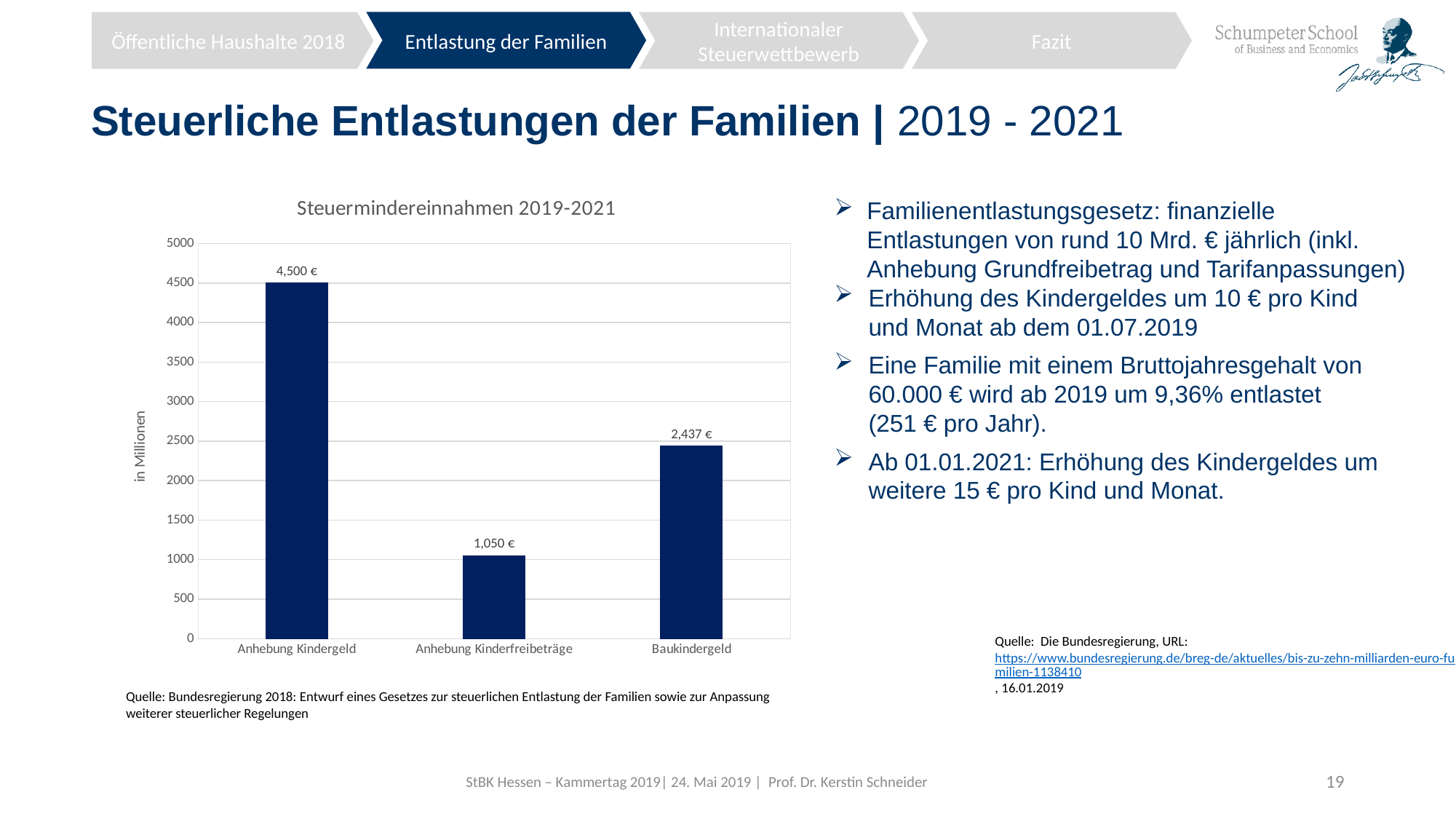
Which category has the lowest value? Anhebung Kinderfreibeträge Which category has the highest value? Anhebung Kindergeld Is the value for Baukindergeld greater or less than 2000? greater What kind of chart is shown on the slide? bar chart What is the difference between the values for Baukindergeld and Anhebung Kinderfreibeträge? 1,387 € What is the value for Anhebung Kinderfreibeträge? 1,050 € What is the difference between the values for Anhebung Kindergeld and Baukindergeld? 2,063 € What is the value for Baukindergeld? 2,437 € What is the value for Anhebung Kindergeld? 4,500 € How many categories are shown in the chart? 3 Which is larger, the value for Baukindergeld or the value for Anhebung Kinderfreibeträge? Baukindergeld What is the title of the chart? Steuermindereinnahmen 2019-2021